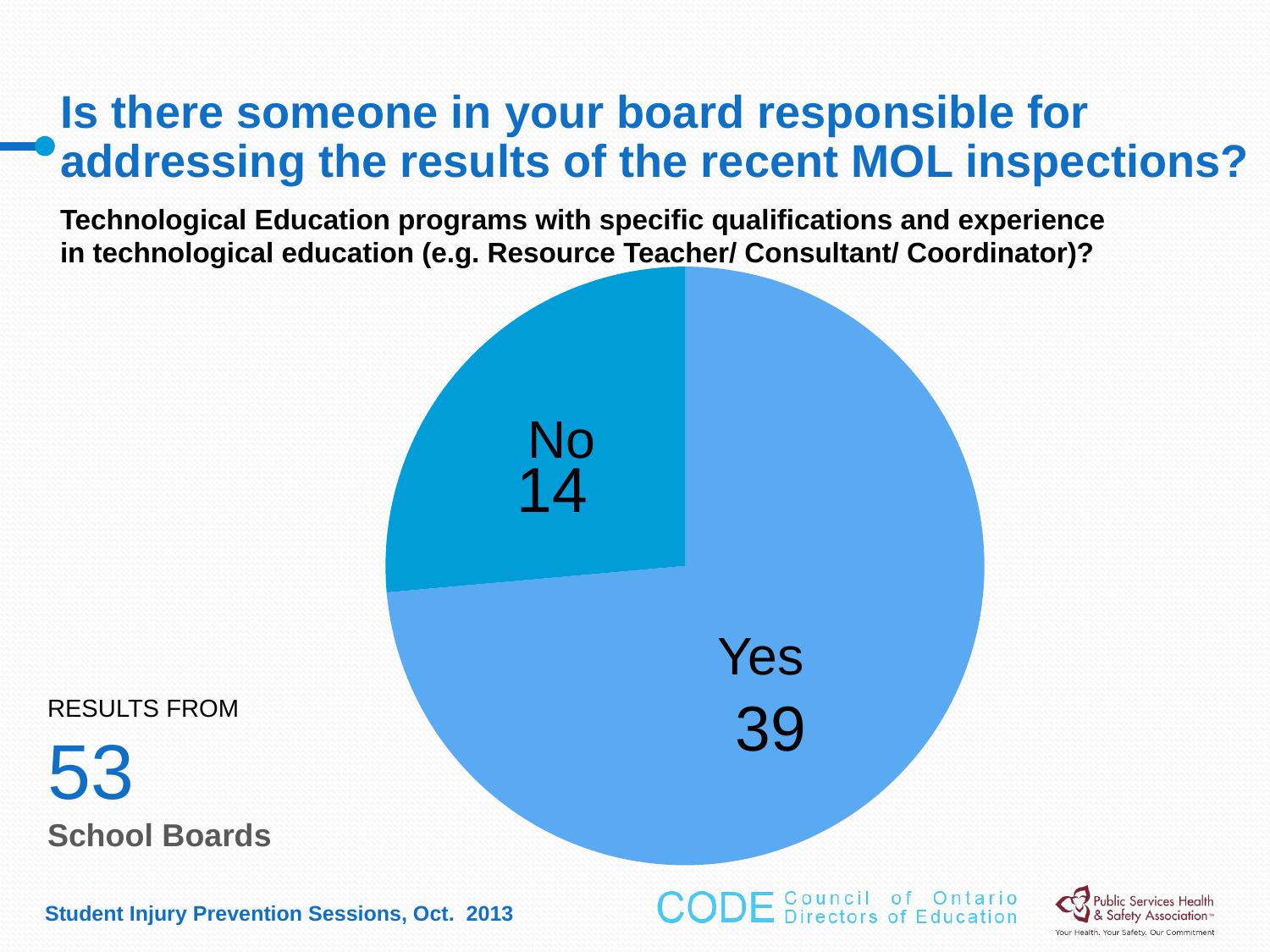
What is the difference between the "Yes" and "No" counts in the pie chart? 25 How many responses are in the "Yes" slice of the pie chart? 39 Which slice of the pie chart is shown in the darker blue colour? No Which slice of the pie chart is the smallest? No Which slice of the pie chart is the largest? Yes Which is larger in the pie chart, "Yes" or "No"? Yes How many responses are in the "No" slice of the pie chart? 14 What share of the total responses does the "Yes" slice represent? 39 out of 53 How many slices does the pie chart have? 2 What type of chart is shown on the slide? pie chart What is the total of the two slices in the pie chart? 53 How many school boards are the results from, according to the slide? 53